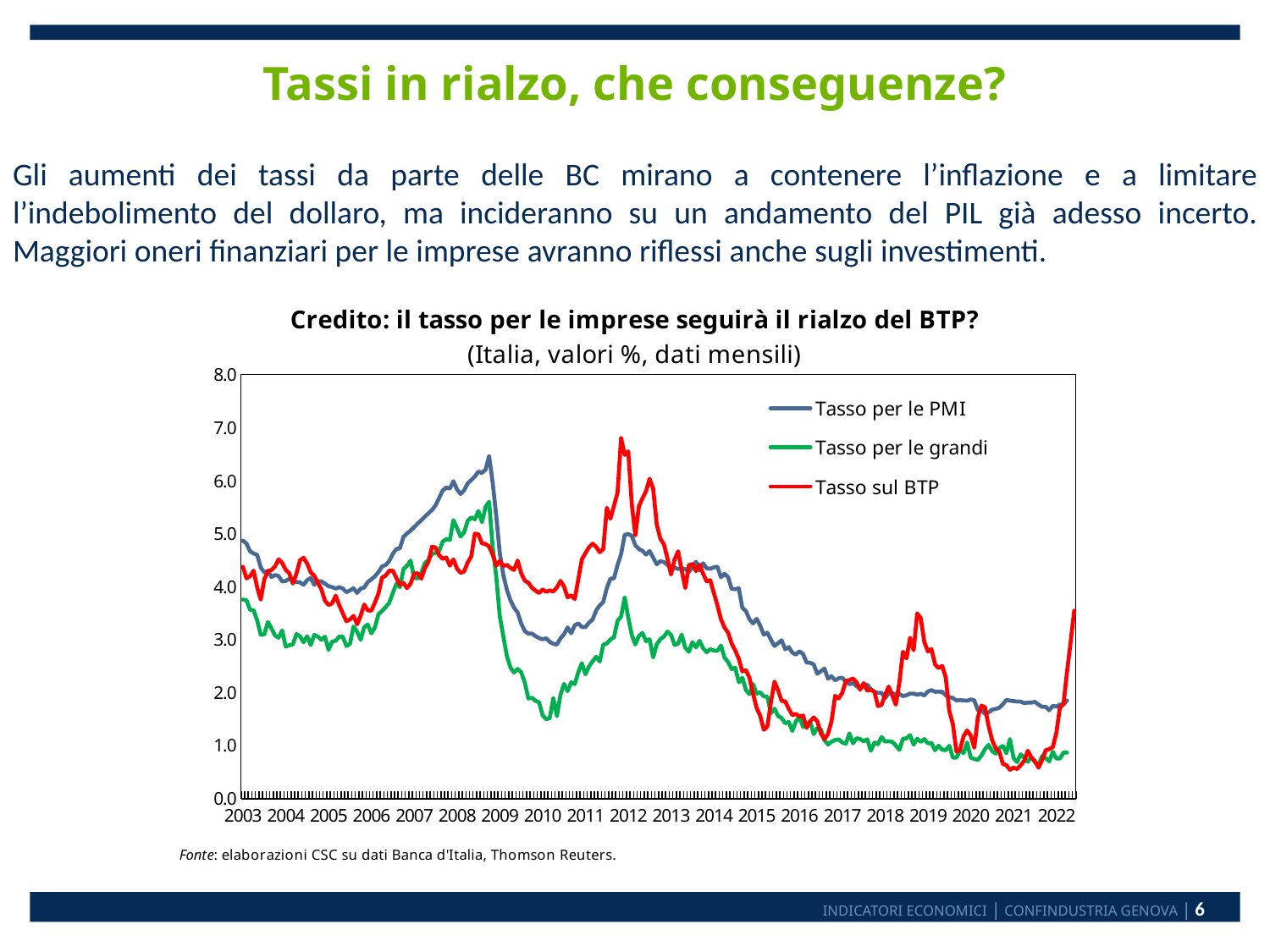
What is the title of the chart? Credito: il tasso per le imprese seguirà il rialzo del BTP? Is the value of Tasso per le grandi during 2021 greater or less than 2.0? less Which series reaches the highest value anywhere on the chart? Tasso sul BTP How many year labels are shown on the x axis of the chart? 20 Does Tasso per le PMI rise or fall between 2014 and 2021? fall Is the peak value of Tasso per le PMI in 2008 greater or less than 6.0? greater What are the three series named in the chart legend? Tasso per le PMI, Tasso per le grandi, Tasso sul BTP What kind of chart is shown on the slide? line chart Is the value of Tasso per le PMI at the start of 2003 greater or less than 4.0? greater How many series does the legend of the chart list? 3 In 2010, which series is higher: Tasso per le PMI or Tasso per le grandi? Tasso per le PMI